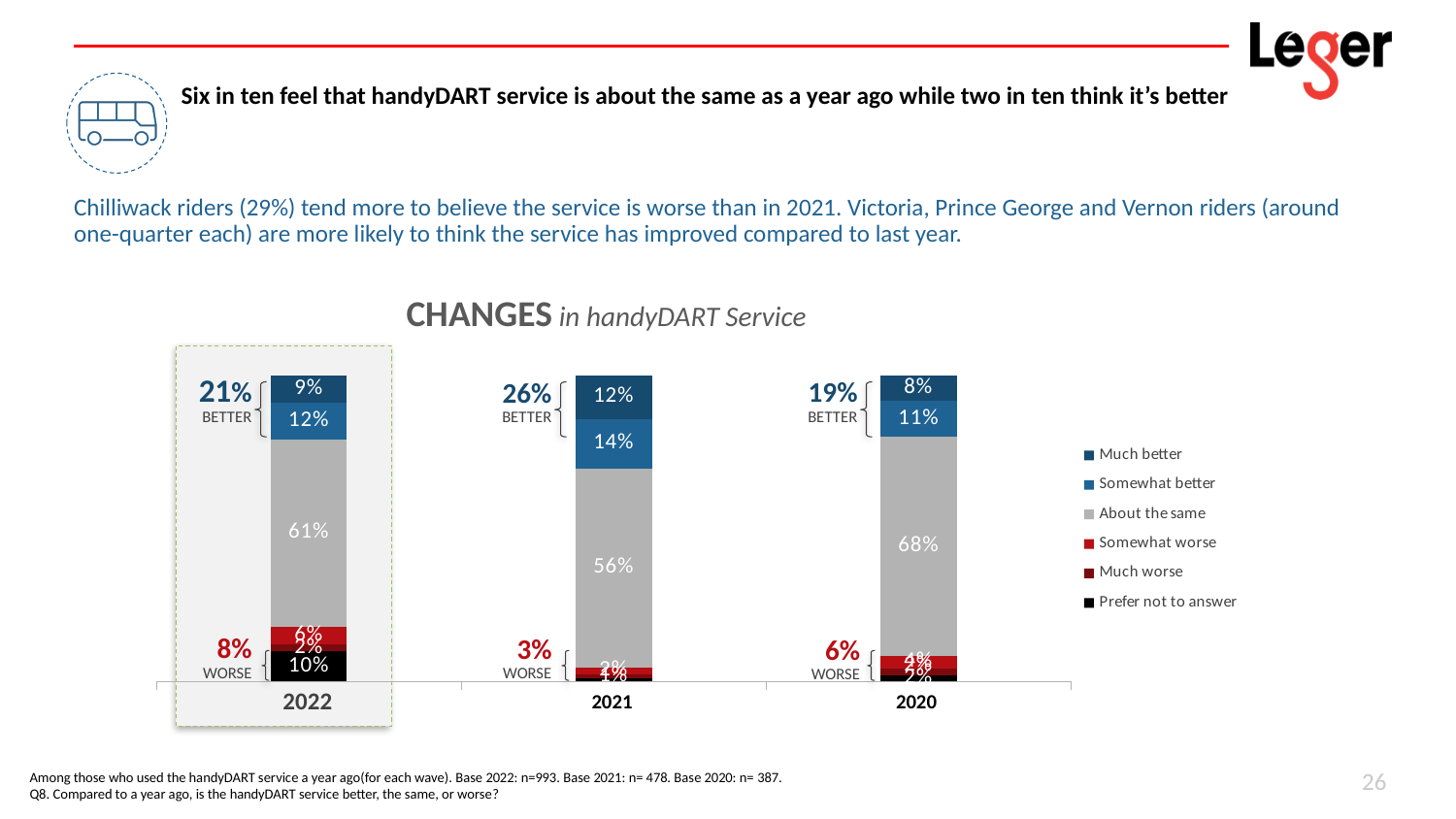
What is the difference between the 'About the same' percentages for 2020 and 2021? 12% How many years are shown on the x axis of the chart? 3 How many series does the legend list? 6 Is the 'Much better' percentage larger in 2021 or in 2020? 2021 What is the WORSE percentage shown for 2022? 8% Which year has the highest 'About the same' percentage? 2020 Which year has the lowest combined BETTER percentage? 2020 What kind of chart is shown on the slide? stacked bar chart What percentage of 2021 riders said the service is 'Much better'? 12% What is the combined BETTER percentage shown for 2021? 26% What percentage of 2022 riders said the service is 'About the same'? 61% What percentage of 2020 riders said the service is 'Somewhat better'? 11%